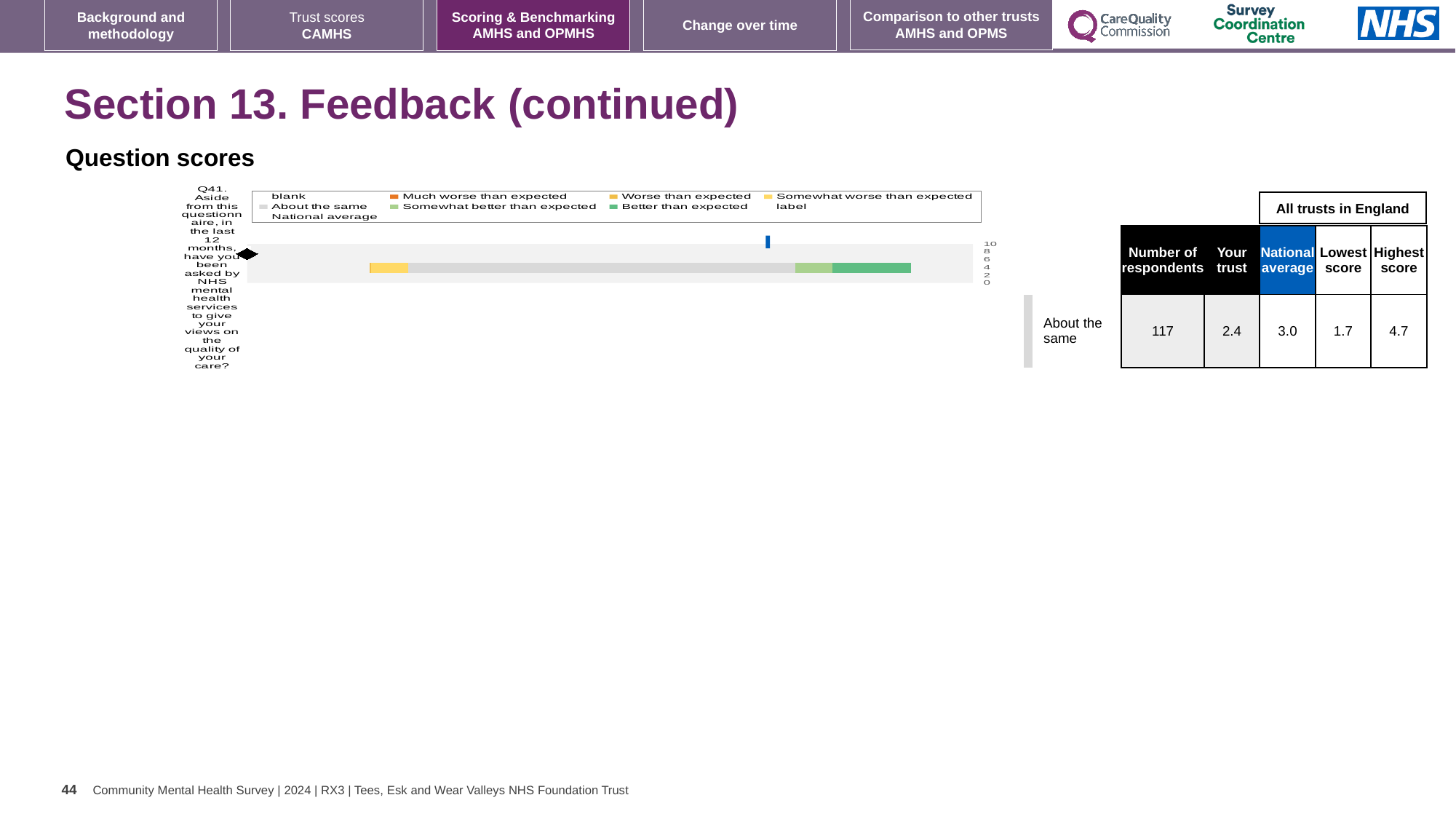
In the table beside the chart, what is the 'Your trust' score for Q41? 2.4 What benchmark category label is shown next to the chart for Q41? About the same How many survey questions are plotted in the chart on the slide? 1 What kind of chart is shown for Q41 on the slide? bar chart In the table beside the chart, how many respondents answered Q41? 117 For Q41, which is larger: the 'Your trust' score or the national average? National average In the table beside the chart, what is the national average score for Q41? 3.0 Which question number is plotted in the chart on the slide? Q41 In the table beside the chart, what is the highest score among all trusts in England for Q41? 4.7 In the table beside the chart, what is the lowest score among all trusts in England for Q41? 1.7 For Q41, what is the difference between the highest score and the lowest score shown in the table beside the chart? 3.0